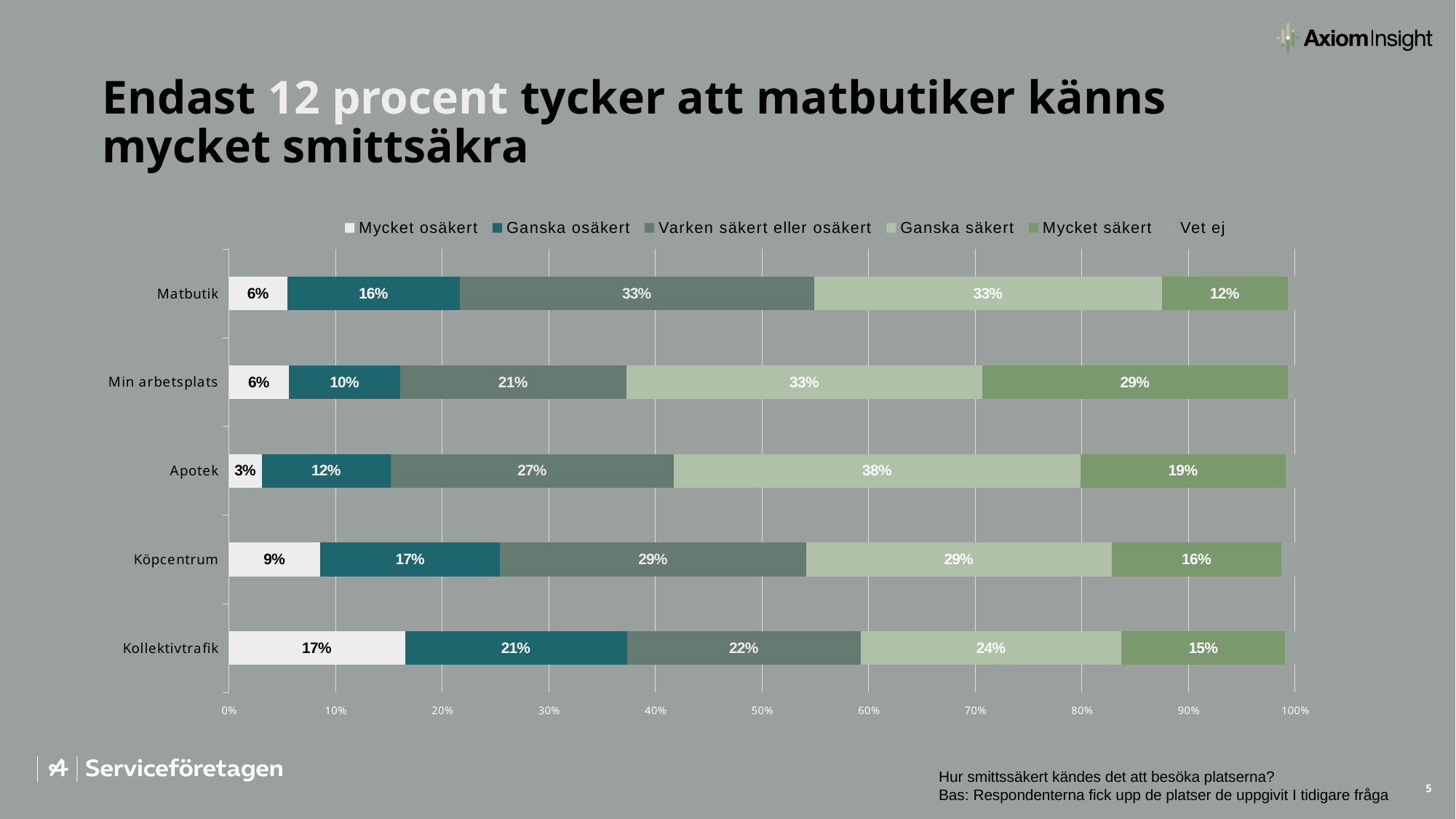
What is the "Mycket osäkert" value for Kollektivtrafik? 17% Which legend entry is shown in the darkest teal colour? Ganska osäkert What is the "Ganska säkert" value for Apotek? 38% Which has a larger "Ganska säkert" value, Apotek or Köpcentrum? Apotek Which category has the lowest "Mycket osäkert" value? Apotek What kind of chart is shown on the slide? Stacked bar chart What percentage of respondents answered "Mycket säkert" for Matbutik? 12% What is the difference in percentage points between the "Mycket säkert" values for Min arbetsplats and Matbutik? 17 How many series does the legend list? 6 How many categories (places) are shown on the y axis of the chart? 5 What is the "Varken säkert eller osäkert" value for Min arbetsplats? 21% Which category has the highest "Mycket säkert" value? Min arbetsplats